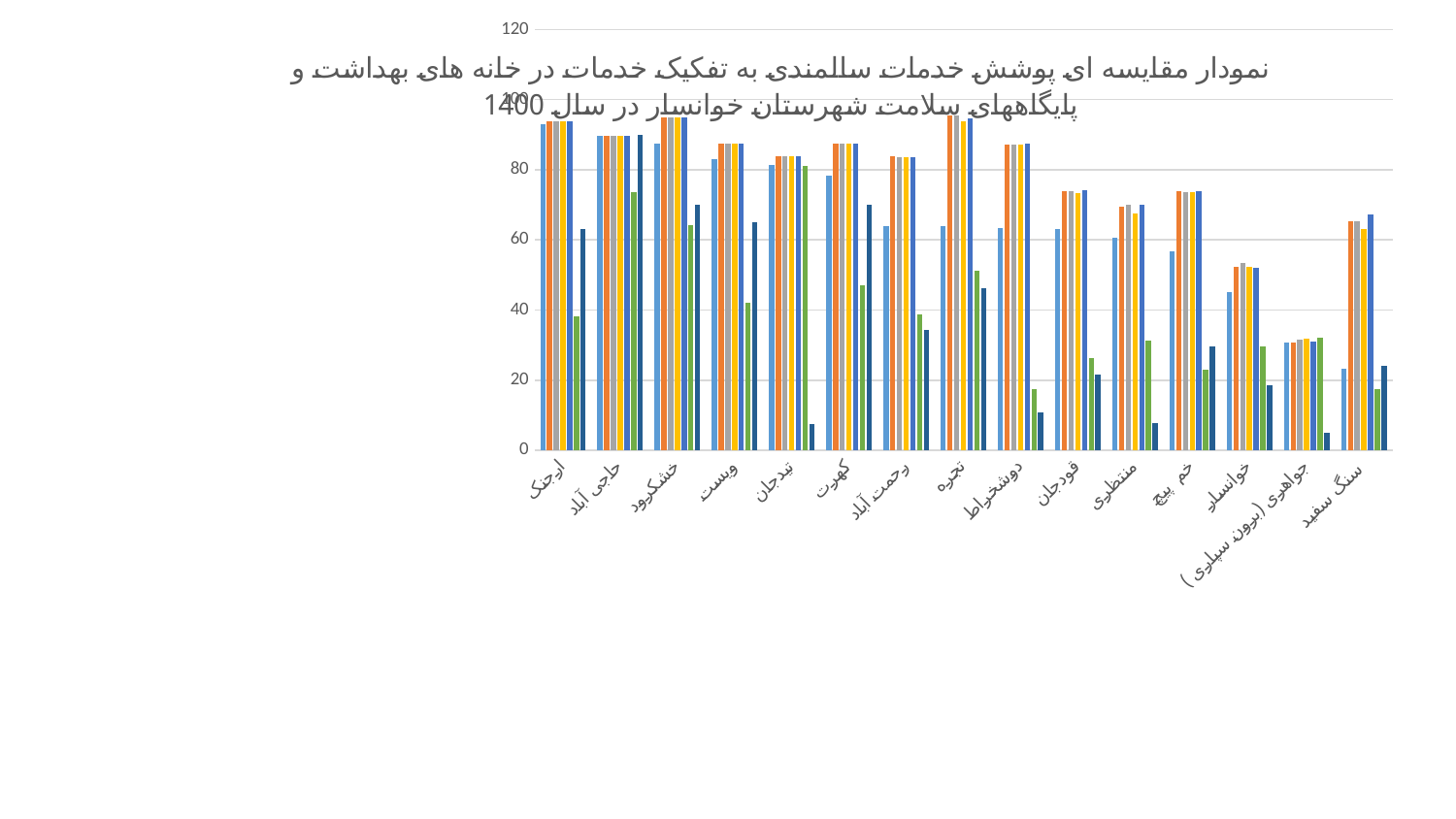
What is the highest value shown on the vertical axis of the chart? 120 Is the shortest bar for بیدجان greater or less than 20? less Which year is mentioned in the chart title? 1400 How many categories are shown along the x axis of the chart? 15 Is the tallest bar for سنگ سفید greater or less than 60? greater Is the shortest bar for دوشخراط greater or less than 20? less What kind of chart is shown on the slide? bar chart Which category has a lower tallest bar, جواهری (برون سپاری) or خم پیچ? جواهری (برون سپاری)